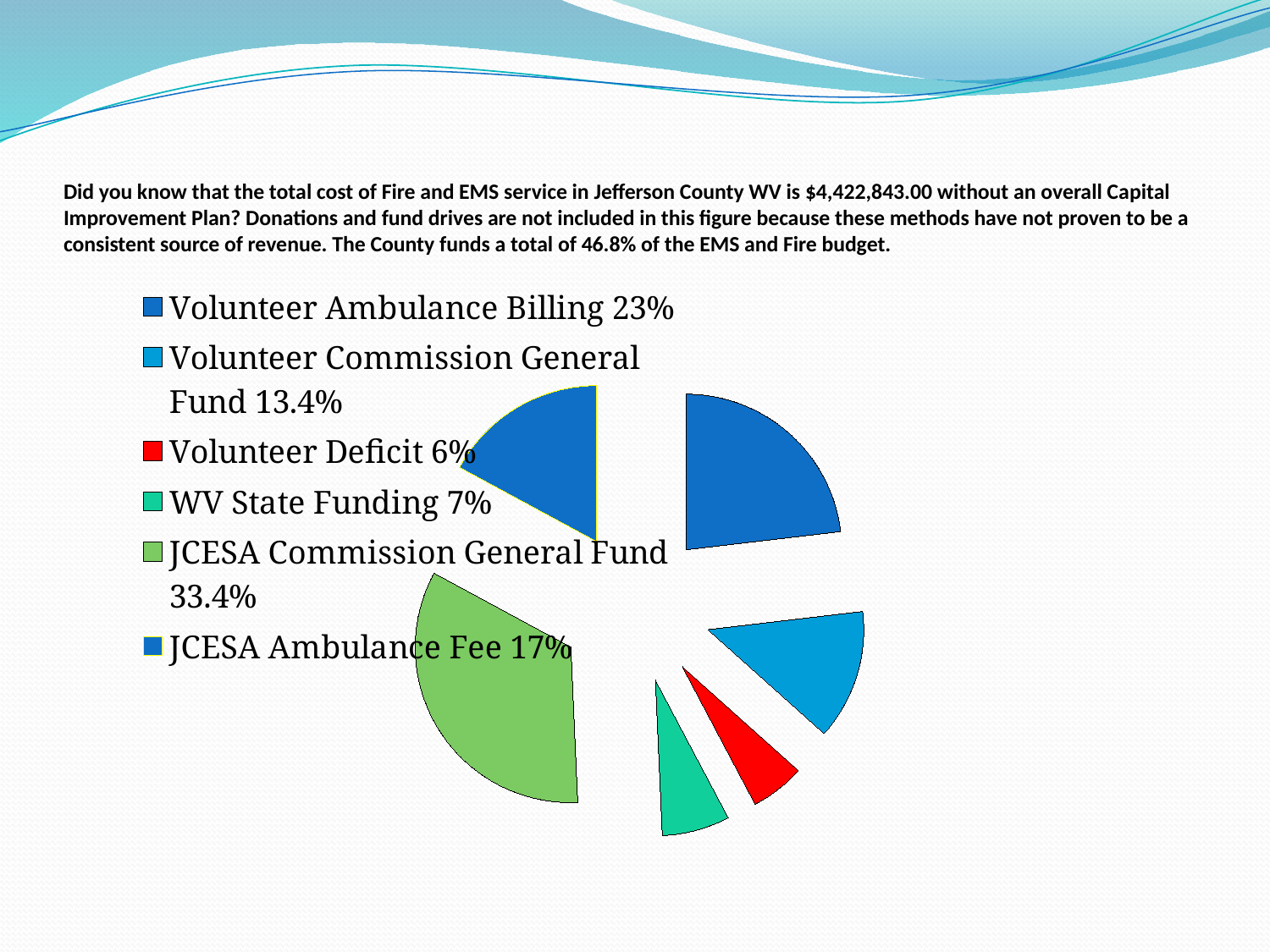
What colour is the Volunteer Deficit slice? red What is the difference in percentage points between JCESA Commission General Fund and Volunteer Ambulance Billing? 10.4 What kind of chart is shown on the slide? pie chart Which category has the largest share of the pie? JCESA Commission General Fund How many slices does the pie chart have? 6 What percentage does the legend give for JCESA Commission General Fund? 33.4% Which is larger, WV State Funding or Volunteer Deficit? WV State Funding What percentage does the legend give for JCESA Ambulance Fee? 17% Which category has the smallest share of the pie? Volunteer Deficit What percentage does the legend give for Volunteer Ambulance Billing? 23% What colour is the JCESA Commission General Fund slice? light green What percentage does the legend give for Volunteer Commission General Fund? 13.4%